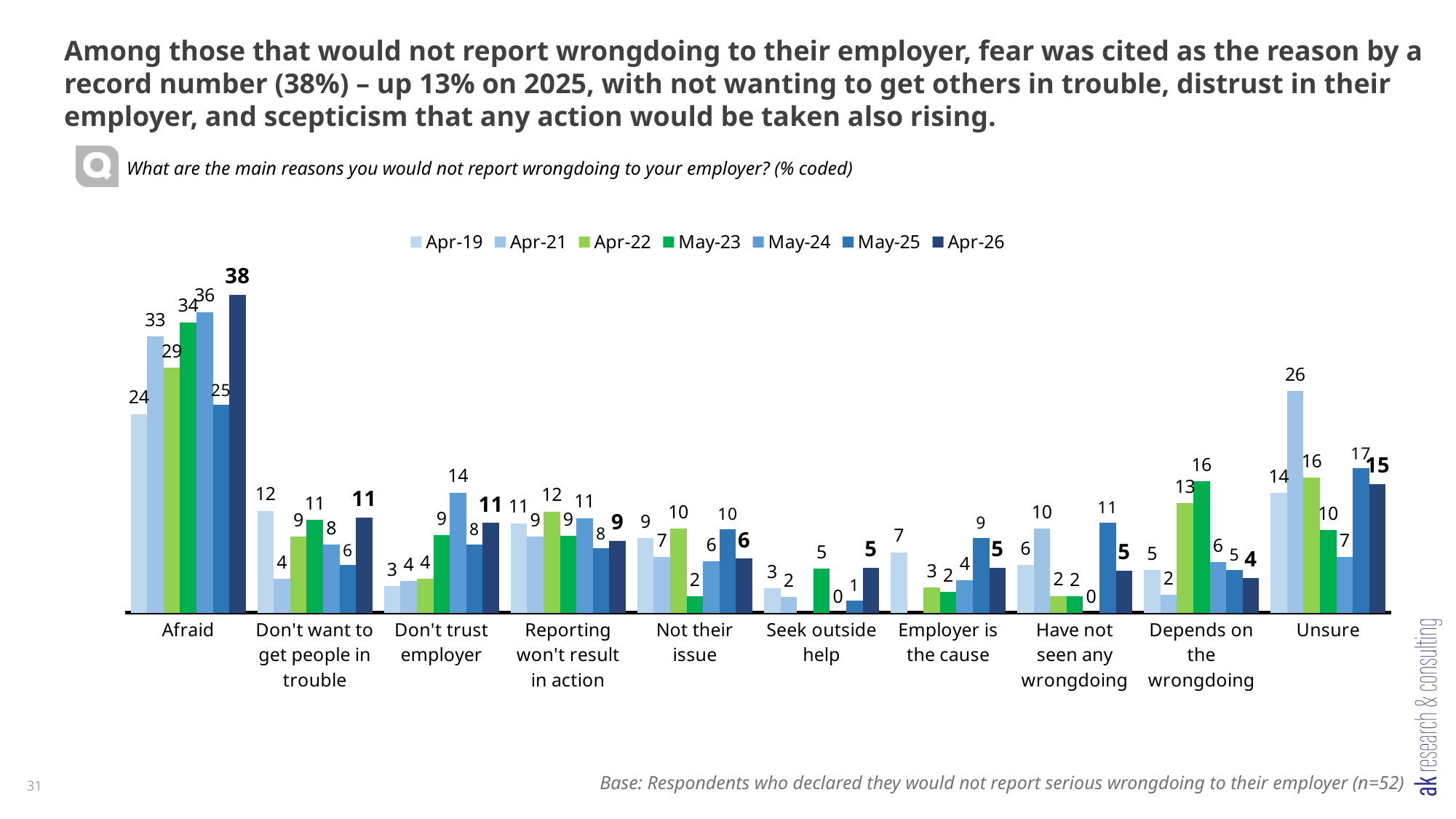
What is the May-25 value for Have not seen any wrongdoing? 11 What is the Apr-26 value for Afraid? 38 What kind of chart is shown on the slide? Bar chart What is the Apr-21 value for Unsure? 26 How many categories are shown on the x axis? 10 Which is larger for Unsure: the Apr-21 value or the Apr-26 value? Apr-21 What is the May-23 value for Depends on the wrongdoing? 16 What is the May-24 value for Don't trust employer? 14 Which category has the lowest Apr-26 value? Depends on the wrongdoing How many series does the legend list? 7 What is the difference between the Apr-26 and May-25 values for Afraid? 13 Which category has the highest Apr-26 value? Afraid